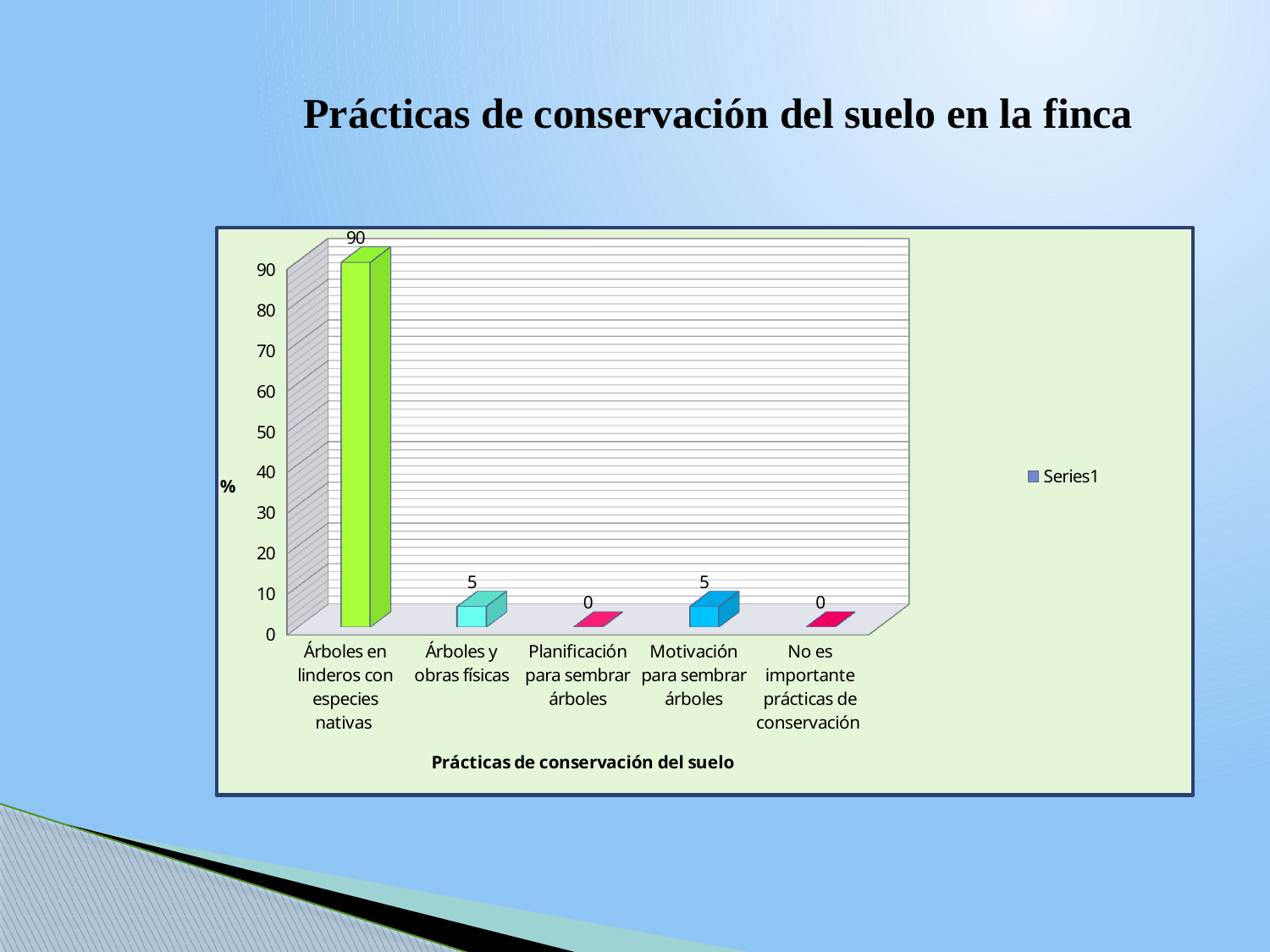
What kind of chart is shown on the slide? bar chart What is the label of the x axis? Prácticas de conservación del suelo What is the value for "Árboles y obras físicas"? 5 What is the title of the chart? Prácticas de conservación del suelo en la finca What is the value for "Árboles en linderos con especies nativas"? 90 What is the value for "Planificación para sembrar árboles"? 0 How many series does the legend list? 1 What is the value for "Motivación para sembrar árboles"? 5 Which is larger, the value for "Árboles y obras físicas" or the value for "No es importante prácticas de conservación"? Árboles y obras físicas What is the difference between the values for "Árboles en linderos con especies nativas" and "Árboles y obras físicas"? 85 How many categories are shown on the x axis? 5 Which category has the highest value? Árboles en linderos con especies nativas